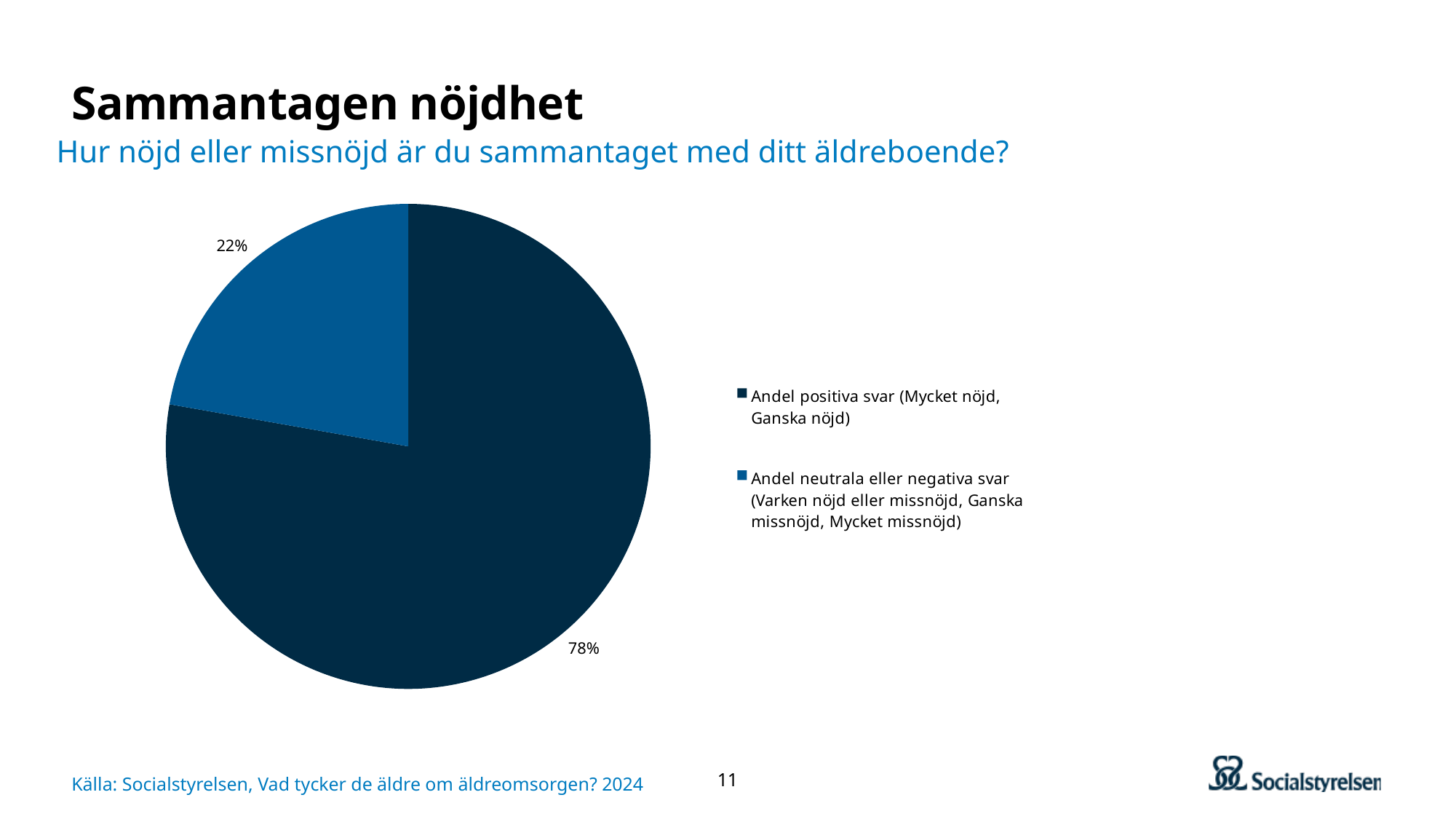
Which is larger: the share of positive answers or the share of neutral or negative answers? Positive answers (78%) What share of the pie is labelled 'Andel neutrala eller negativa svar (Varken nöjd eller missnöjd, Ganska missnöjd, Mycket missnöjd)'? 22% How many entries does the legend list? 2 What is the source cited below the chart? Socialstyrelsen, Vad tycker de äldre om äldreomsorgen? 2024 Which slice of the pie is the largest? Andel positiva svar (Mycket nöjd, Ganska nöjd) What kind of chart is shown on the slide? Pie chart What question does the chart's subtitle pose? Hur nöjd eller missnöjd är du sammantaget med ditt äldreboende? What is the difference in percentage points between the positive slice and the neutral/negative slice? 56 percentage points What share of the pie is labelled 'Andel positiva svar (Mycket nöjd, Ganska nöjd)'? 78% Which slice of the pie is the smallest? Andel neutrala eller negativa svar (Varken nöjd eller missnöjd, Ganska missnöjd, Mycket missnöjd) How many slices does the pie chart have? 2